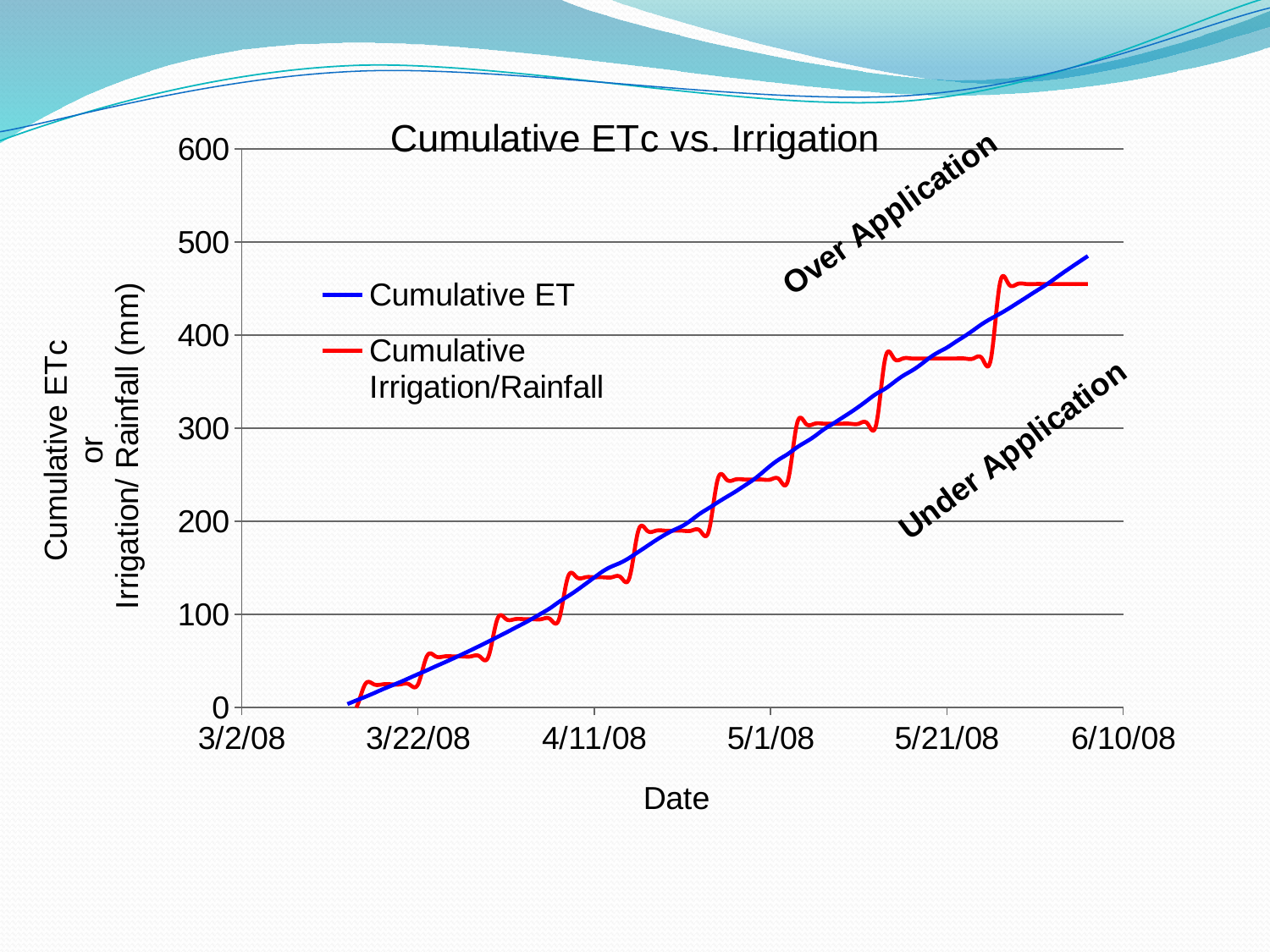
Which series is drawn in red? Cumulative Irrigation/Rainfall What is the title of the chart? Cumulative ETc vs. Irrigation Does the Cumulative Irrigation/Rainfall line generally rise or fall from 3/22/08 to 6/10/08? rise Does the Cumulative ET line rise or fall as the date increases? rise Is the Cumulative ET value at 5/21/08 greater or less than 300? greater Is the Cumulative ET value at 4/11/08 greater or less than 200? less How many date labels are shown on the x axis? 6 Is the Cumulative ET value at 5/1/08 greater or less than 200? greater What kind of chart is shown on the slide? line chart How many series does the legend list? 2